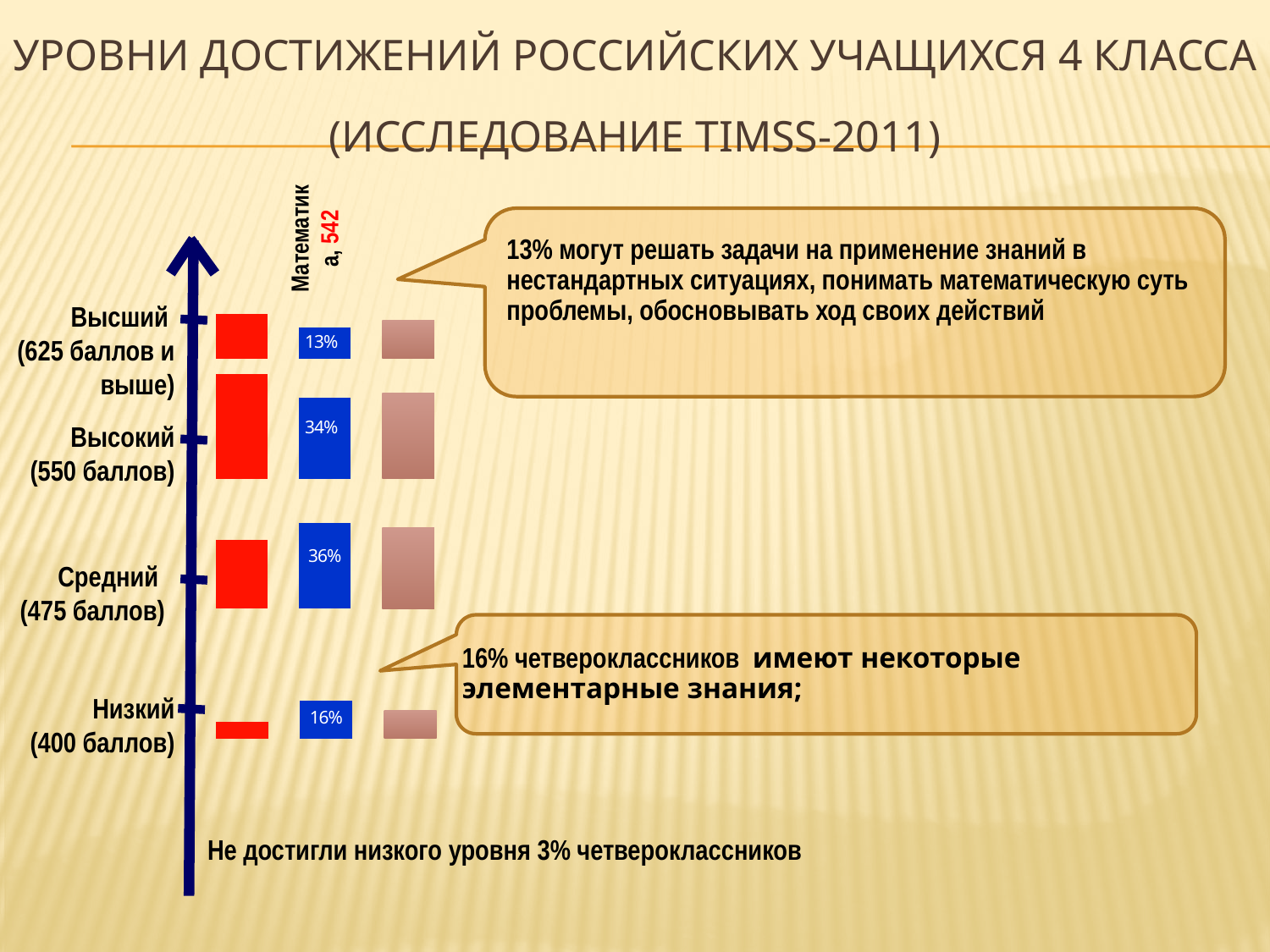
What kind of chart is used to show the percentages? Bar chart What percentage is shown for the Высший level (625 баллов и выше) in the blue bar? 13% Which achievement level has the lowest labelled percentage? Высший (625 баллов и выше) Which is larger, the percentage for the Высокий level or the Низкий level? Высокий What percentage is shown for the Средний level (475 баллов)? 36% What label and score are written above the bars for the subject? Математика, 542 What percentage is shown for the Высокий level (550 баллов)? 34% Which achievement level has the highest labelled percentage? Средний (475 баллов) What is the difference between the percentages for the Высокий and Низкий levels? 18% What is the difference between the percentages for the Средний and Высший levels? 23% How many achievement levels are shown on the vertical scale? 4 What percentage is shown for the Низкий level (400 баллов)? 16%